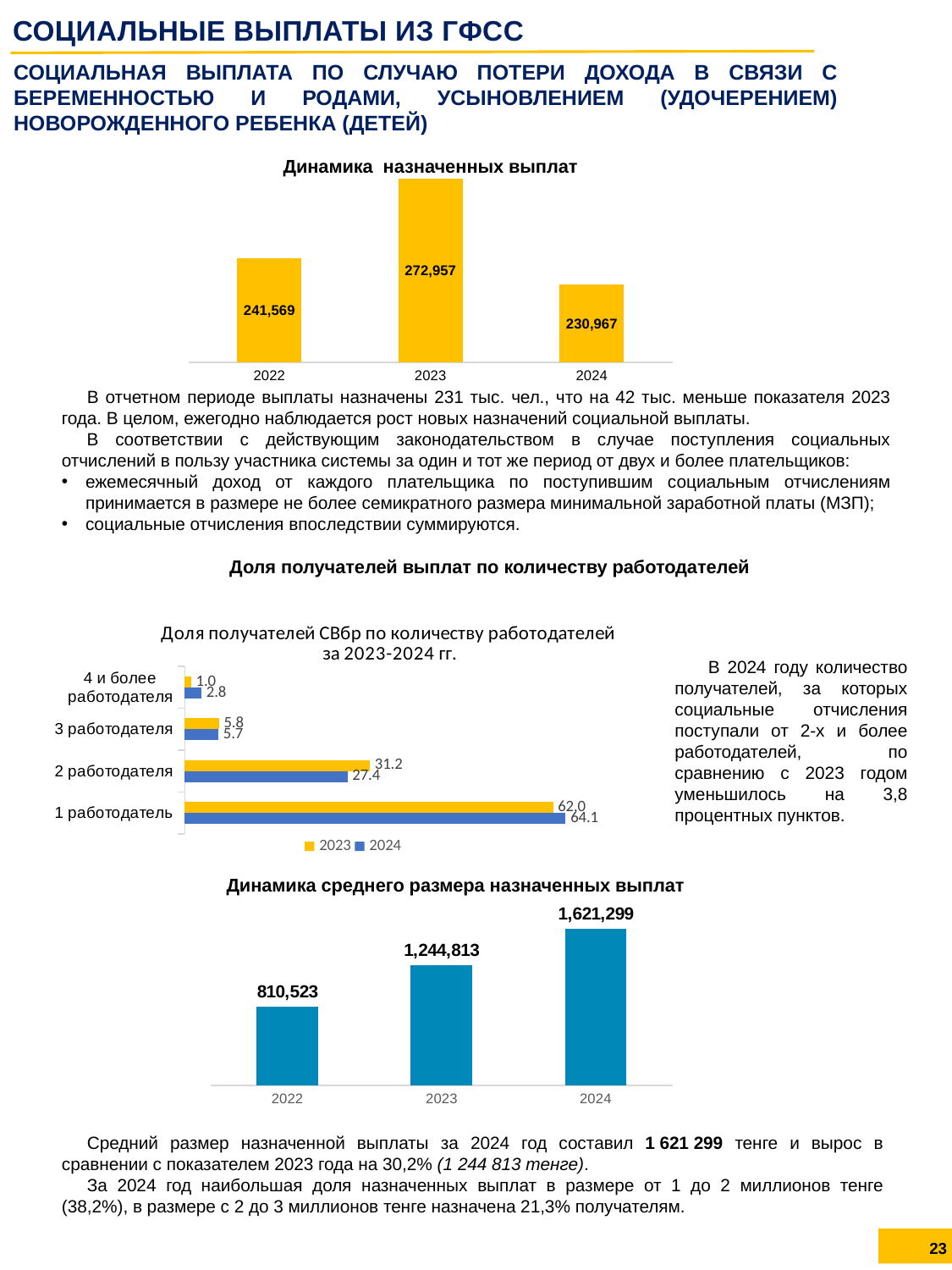
How many series does the legend list in the chart 'Доля получателей СВбр по количеству работодателей за 2023-2024 гг.'? 2 In the chart 'Динамика назначенных выплат', what is the difference between the 2023 and 2024 values? 41,990 How many bars are shown in the chart 'Динамика назначенных выплат'? 3 In the chart 'Динамика назначенных выплат', what is the value for 2023? 272,957 In the chart 'Динамика среднего размера назначенных выплат', what is the value for 2022? 810,523 In the chart 'Динамика среднего размера назначенных выплат', what is the difference between the 2024 and 2023 values? 376,486 In the chart 'Динамика назначенных выплат', which year has the lowest value? 2024 In the chart 'Доля получателей СВбр по количеству работодателей за 2023-2024 гг.', what is the 2024 value for '1 работодатель'? 64.1 In the chart 'Динамика среднего размера назначенных выплат', do the values rise or fall from 2022 to 2024? Rise In the chart 'Доля получателей СВбр по количеству работодателей за 2023-2024 гг.', what is the 2023 value for '2 работодателя'? 31.2 What type of chart is 'Доля получателей СВбр по количеству работодателей за 2023-2024 гг.'? Bar chart In the chart 'Доля получателей СВбр по количеству работодателей за 2023-2024 гг.', which is larger for '4 и более работодателя': the 2023 value or the 2024 value? 2024